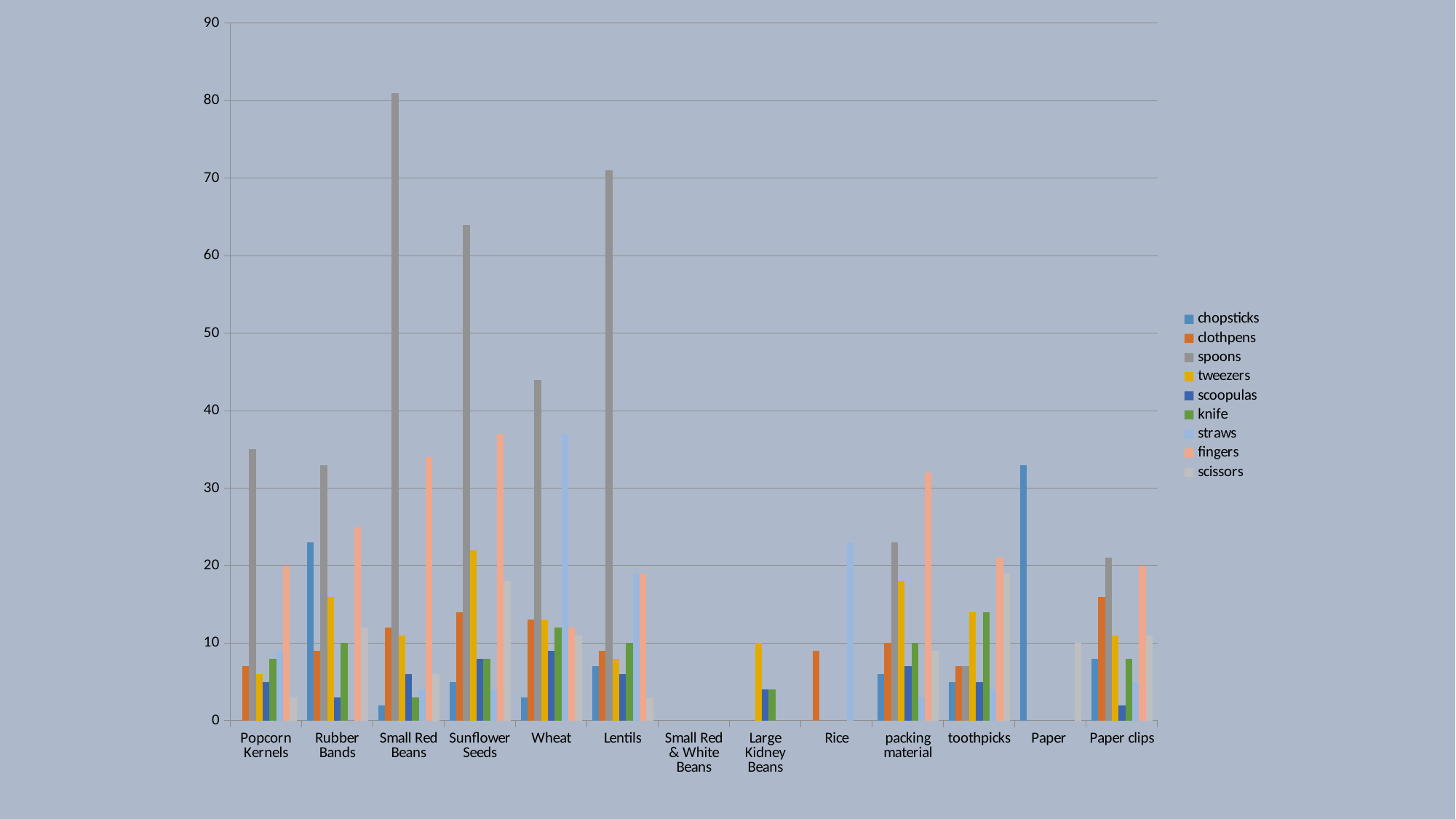
Which series is listed last in the legend? scissors Is the value for chopsticks for Paper greater or less than 30? greater Is the value for spoons for Wheat greater or less than 50? less Is the value for spoons for Small Red Beans greater or less than 70? greater What kind of chart is shown on the slide? bar chart Which is larger, the spoons value for Lentils or the spoons value for Wheat? Lentils How many series does the legend list? 9 Which category has the highest value for chopsticks? Paper Which category has the highest value for spoons? Small Red Beans How many categories are shown along the x axis? 13